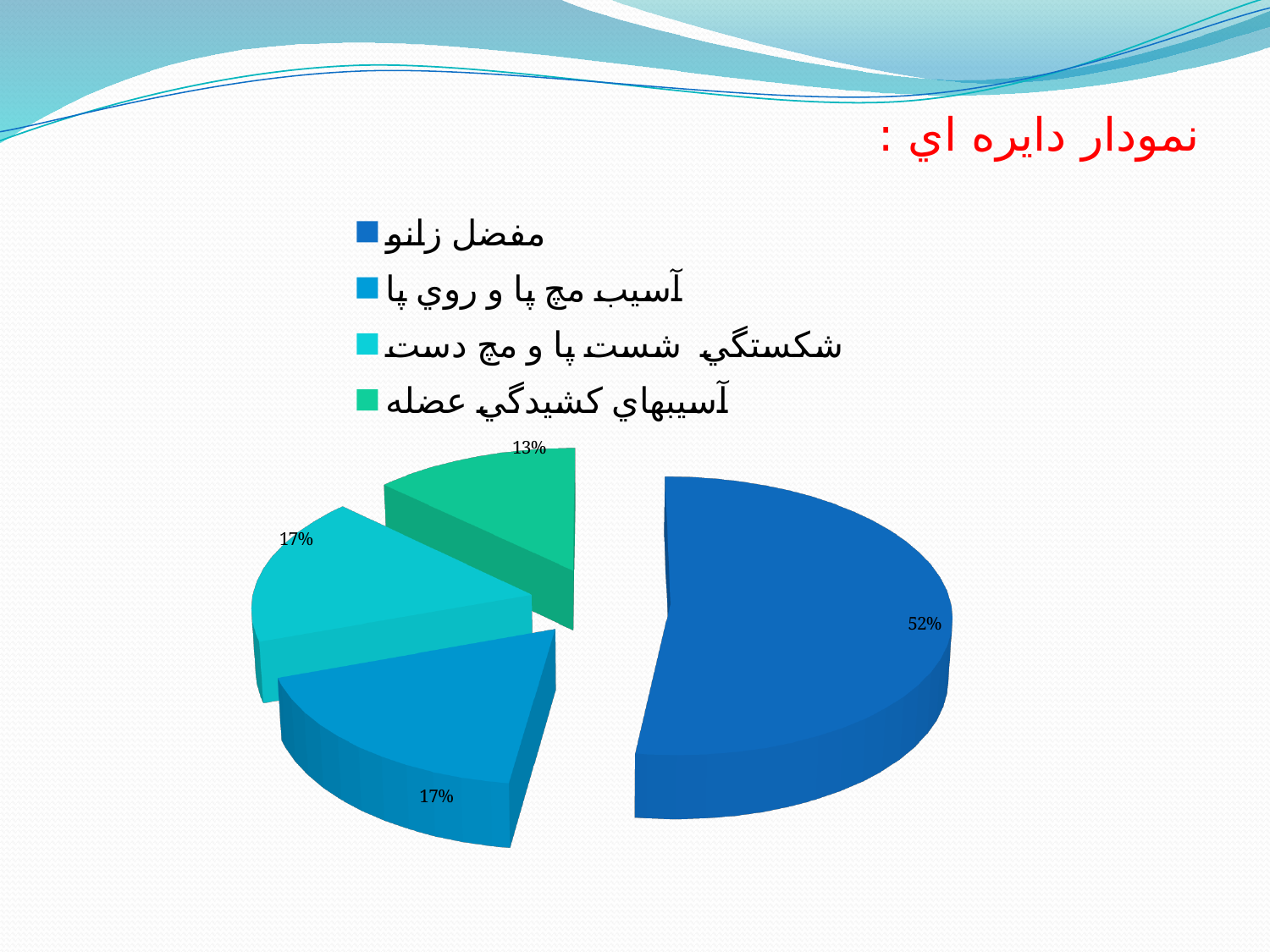
What is the difference in percentage points between مفصل زانو and آسيبهاي كشيدگي عضله? 39 What percentage of the pie does آسيب مچ پا و روي پا account for? 17% Which category has the largest share of the pie? مفضل زانو How many slices does the pie chart have? 4 What percentage of the pie does شكستگي شست پا و مچ دست account for? 17% How many entries does the legend list? 4 Which is larger, the share for مفصل زانو or the share for شكستگي شست پا و مچ دست? مفضل زانو What percentage of the pie does آسيبهاي كشيدگي عضله account for? 13% What kind of chart is shown on the slide? pie chart What colour is the slice for آسيبهاي كشيدگي عضله? green Which category has the smallest share of the pie? آسيبهاي كشيدگي عضله What percentage of the pie does مفصل زانو account for? 52%